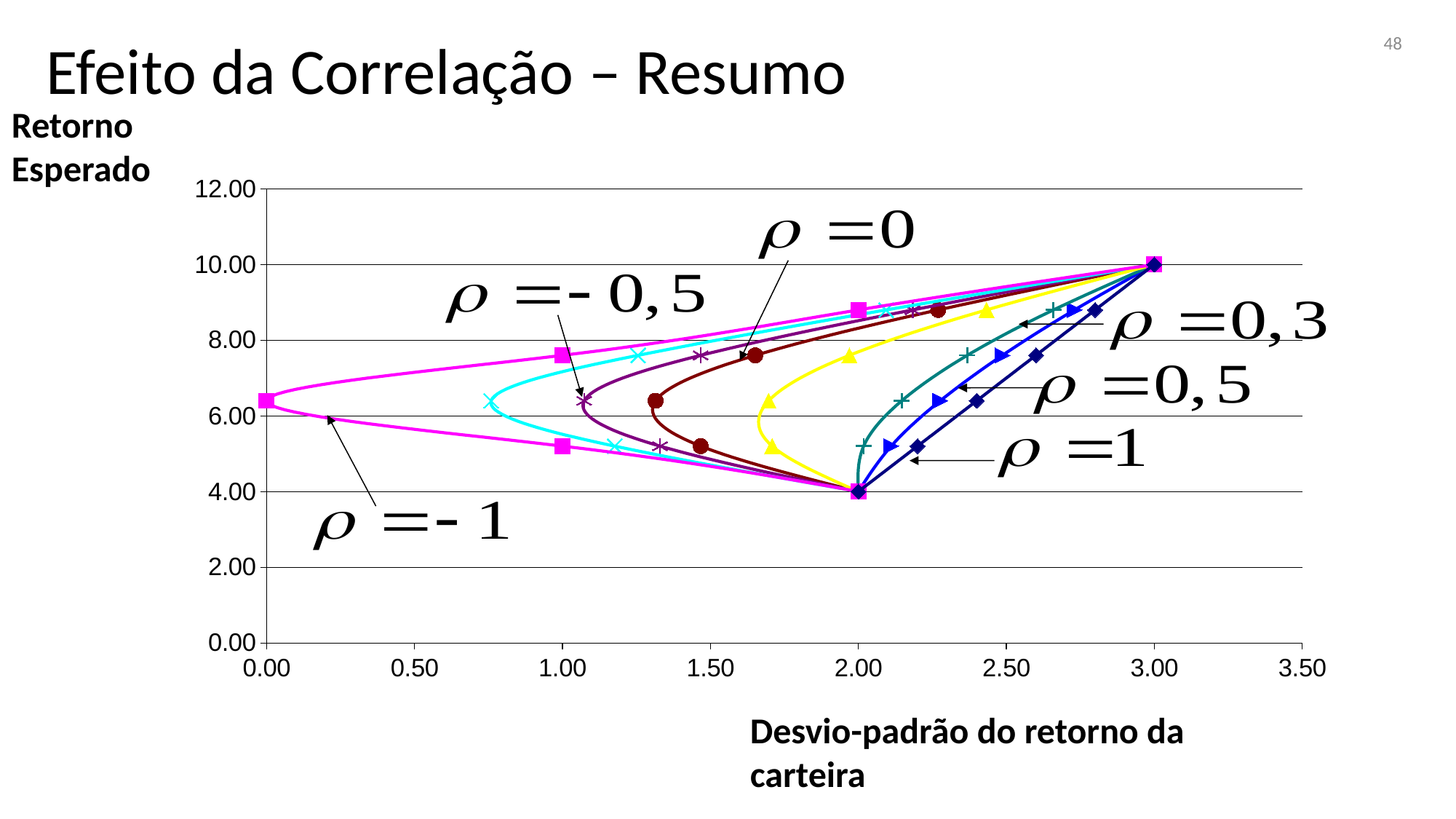
What is the expected return at the lower point where the curves converge at a standard deviation of 2.00? 4.00 What is the expected return at the top-right point where all the curves meet? 10.00 What is the title of the slide containing the chart? Efeito da Correlação – Resumo What is the smallest standard deviation reached by the ρ = -1 curve? 0.00 Along the ρ = 1 line, does the expected return rise or fall as the standard deviation increases? rise What is the label of the horizontal axis of the chart? Desvio-padrão do retorno da carteira Is the smallest standard deviation reached by the ρ = 0 curve greater or less than 1.50? less How many different correlation values (ρ) are labelled on the chart? 6 Which curve reaches the lowest standard deviation, ρ = -1 or ρ = 1? ρ = -1 At what standard deviation value do all the curves meet at the top right of the chart? 3.00 Is the smallest standard deviation reached by the ρ = 0.3 curve greater or less than 1.50? greater What kind of chart is shown on the slide? line chart